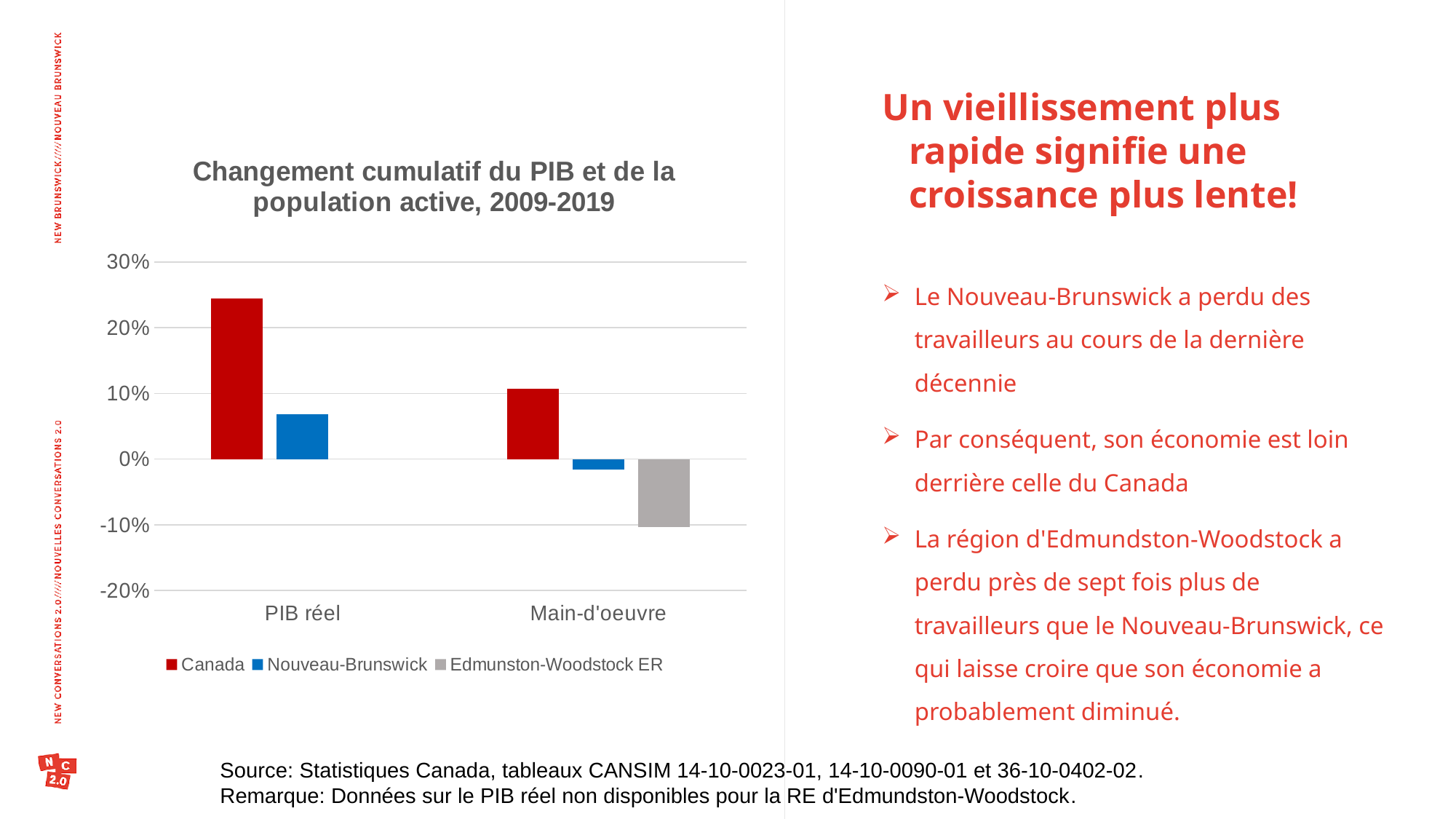
Is the value for Canada in the PIB réel category greater or less than 20%? greater What is the title of the chart? Changement cumulatif du PIB et de la population active, 2009-2019 Is the value for Nouveau-Brunswick in the Main-d'oeuvre category greater or less than 0%? less Which series is shown in grey in the legend? Edmunston-Woodstock ER Is the value for Edmunston-Woodstock ER in the Main-d'oeuvre category greater or less than 0%? less How many series does the legend list? 3 What kind of chart is shown on the slide? bar chart Which series has the highest value in the PIB réel category? Canada How many categories are shown on the x axis? 2 Which series has the lowest value in the Main-d'oeuvre category? Edmunston-Woodstock ER